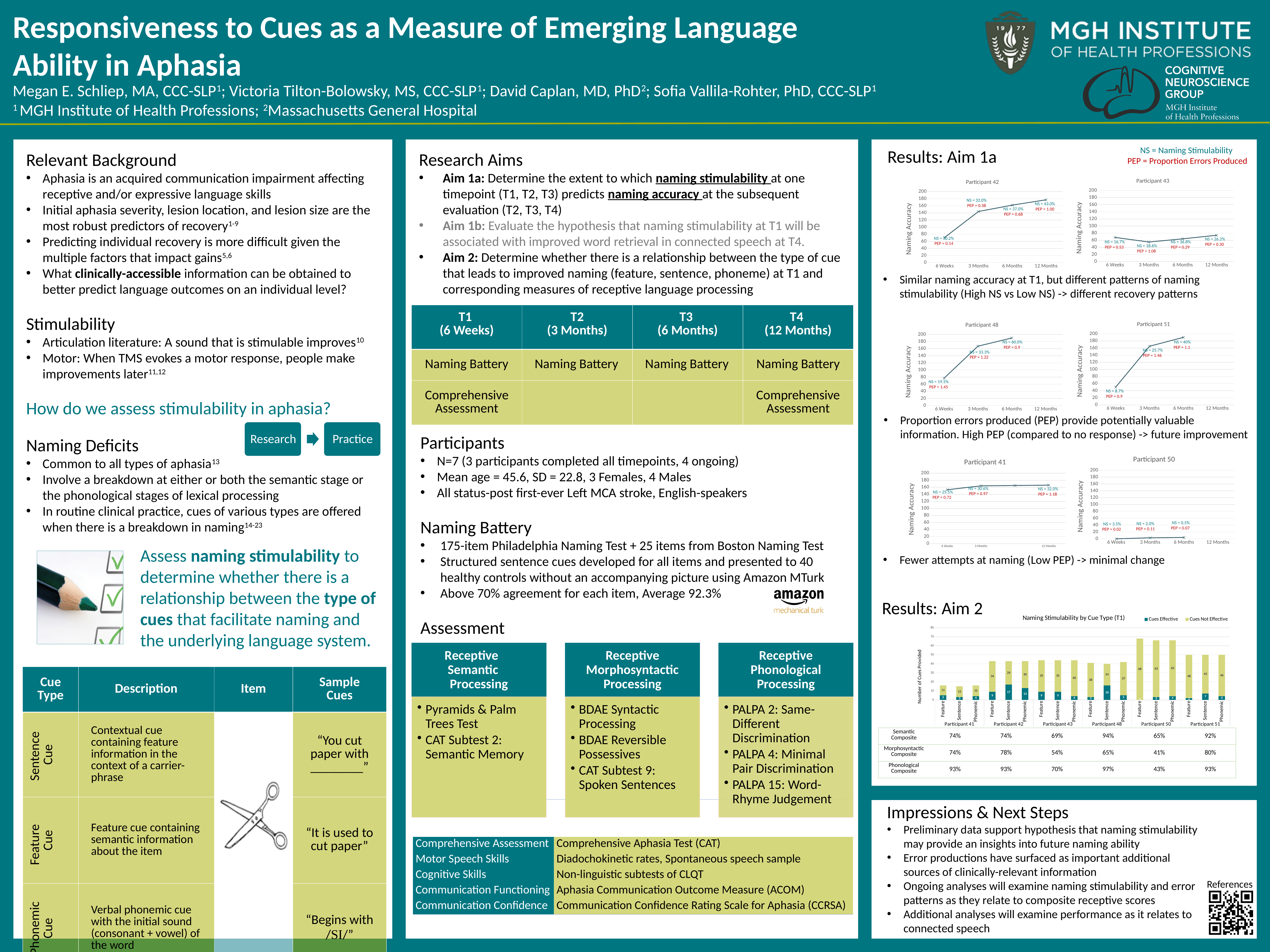
What are the two legend entries in the 'Naming Stimulability by Cue Type (T1)' chart? Cues Effective, Cues Not Effective In the 'Participant 42' chart, what is the PEP value labelled at 6 Weeks? 0.14 How many timepoints are shown on the x axis of the 'Participant 43' chart? 4 In the 'Naming Stimulability by Cue Type (T1)' chart, which bar has the highest Cues Not Effective value? Participant 50, Feature In the 'Participant 42' chart, what is the NS value labelled at 12 Months? 43.0% In the 'Participant 48' chart, does naming accuracy rise or fall from 6 Weeks to 6 Months? rise What kind of chart is the 'Participant 42' chart under Results: Aim 1a? line chart In the 'Participant 51' chart, is the naming accuracy at 6 Weeks greater or less than 100? less In the 'Naming Stimulability by Cue Type (T1)' chart, is the total height of the Feature bar for Participant 50 greater or less than 60? greater In the 'Naming Stimulability by Cue Type (T1)' chart, what is the Cues Not Effective value for the Feature cue of Participant 50? 68 How many series does the legend of the 'Naming Stimulability by Cue Type (T1)' chart list? 2 What kind of chart is 'Naming Stimulability by Cue Type (T1)' under Results: Aim 2? bar chart